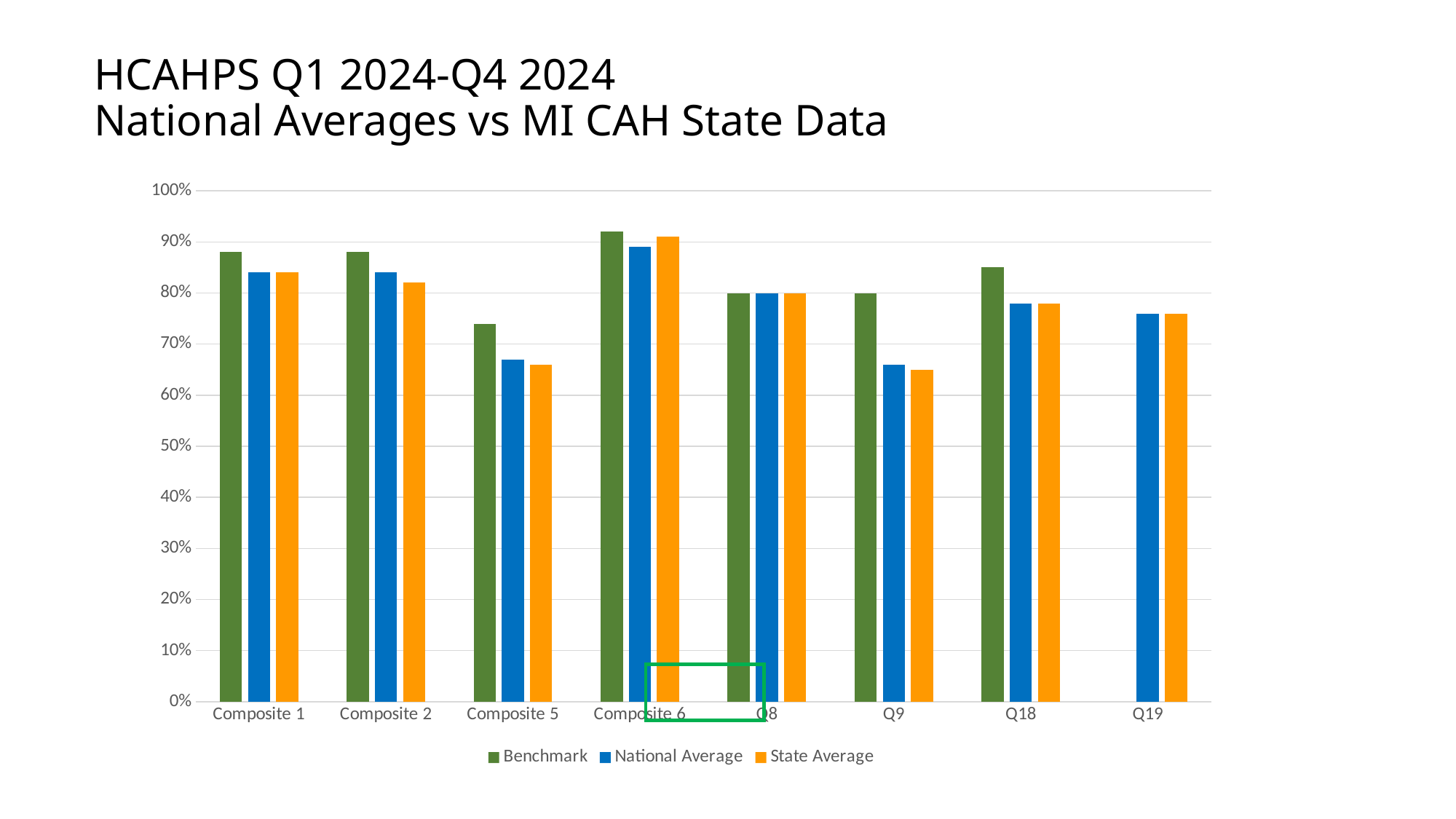
For Composite 5, which is larger: the Benchmark value or the National Average value? Benchmark Is the National Average value for Q19 greater or less than 80%? less How many categories are shown along the x axis? 8 How many series does the legend list? 3 Which category has the lowest Benchmark value? Composite 5 What kind of chart is shown on the slide? bar chart Is the Benchmark value for Q18 greater or less than 80%? greater Is the National Average value for Composite 5 greater or less than 70%? less Which category has the highest Benchmark value? Composite 6 Which category has no Benchmark bar plotted? Q19 For Q9, which is larger: the Benchmark value or the State Average value? Benchmark